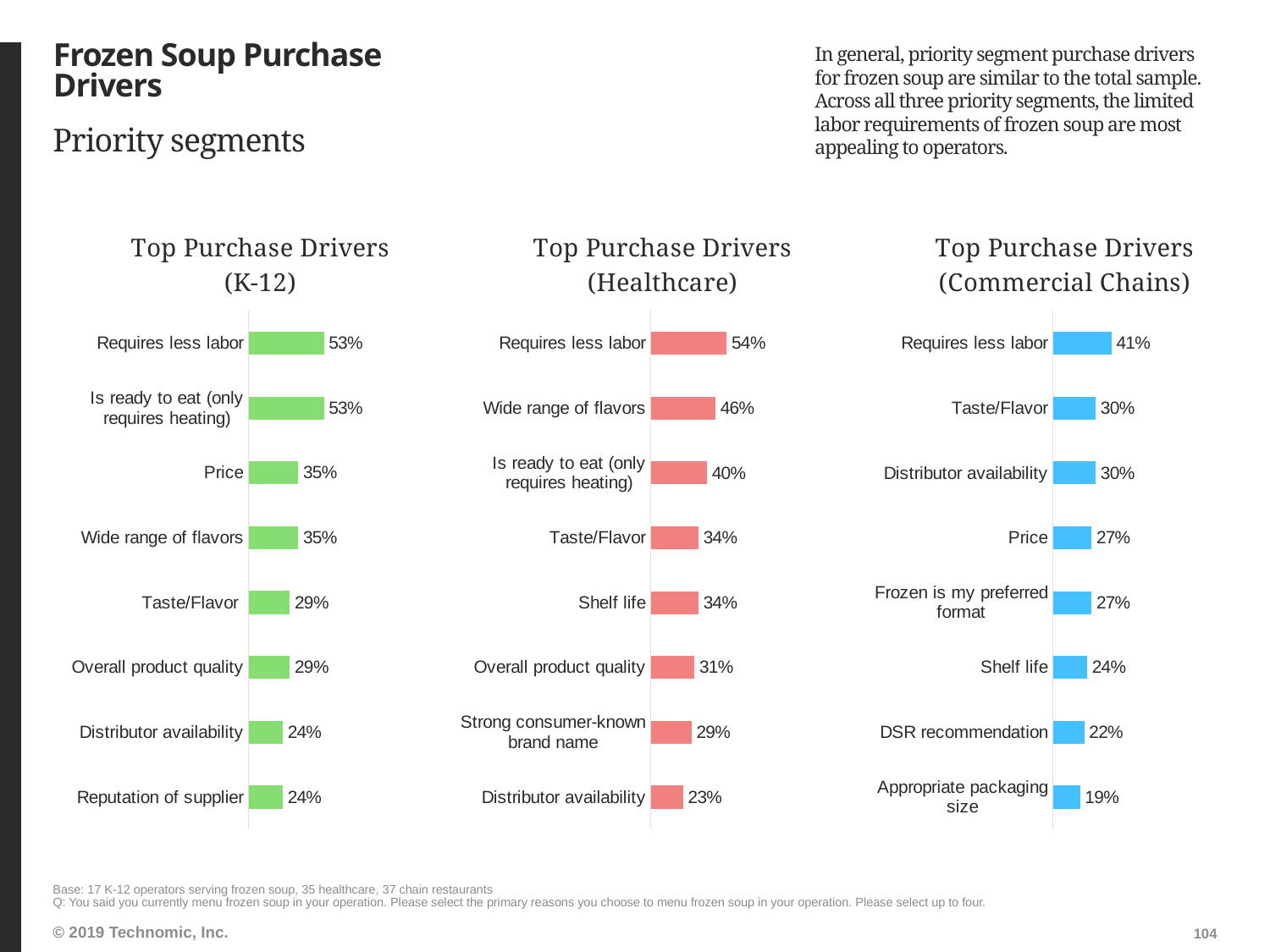
What kind of chart is the Top Purchase Drivers (Commercial Chains) chart? Bar chart In the Top Purchase Drivers (K-12) chart, what is the value for Price? 35% In the Top Purchase Drivers (Commercial Chains) chart, which category has the lowest value? Appropriate packaging size In the Top Purchase Drivers (K-12) chart, what is the difference between Requires less labor and Reputation of supplier? 29% In the Top Purchase Drivers (Healthcare) chart, which is larger: Wide range of flavors or Is ready to eat (only requires heating)? Wide range of flavors In the Top Purchase Drivers (Healthcare) chart, what is the value for Wide range of flavors? 46% In the Top Purchase Drivers (Healthcare) chart, which category has the lowest value? Distributor availability In the Top Purchase Drivers (Commercial Chains) chart, what is the difference between Requires less labor and Taste/Flavor? 11% In the Top Purchase Drivers (Commercial Chains) chart, what is the value for DSR recommendation? 22% What colour are the bars in the Top Purchase Drivers (Healthcare) chart? Red In the Top Purchase Drivers (Healthcare) chart, which category has the highest value? Requires less labor How many categories are shown in the Top Purchase Drivers (K-12) chart? 8